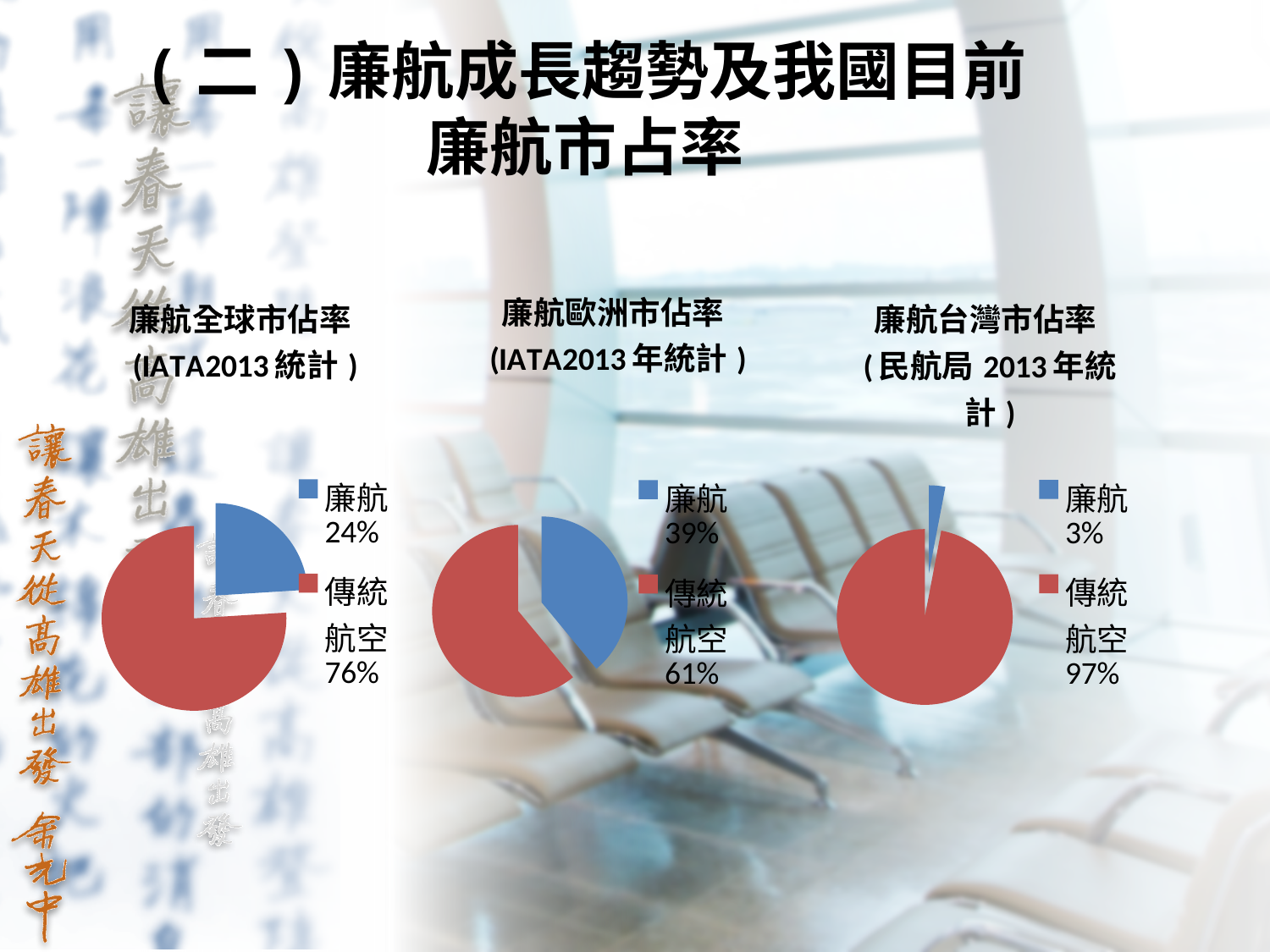
In the right pie chart (廉航台灣市佔率), what share is labelled for 廉航? 3% In the middle pie chart (廉航歐洲市佔率), what share is labelled for 傳統航空? 61% In the left pie chart (廉航全球市佔率), what share is labelled for 廉航? 24% In the middle pie chart (廉航歐洲市佔率), which slice is larger, 廉航 or 傳統航空? 傳統航空 How many slices does the left pie chart (廉航全球市佔率) have? 2 In the middle pie chart (廉航歐洲市佔率), what colour is the 廉航 slice? Blue What kind of chart is used for 廉航全球市佔率? Pie chart In the left pie chart (廉航全球市佔率), what share is labelled for 傳統航空? 76% In the middle pie chart (廉航歐洲市佔率), what share is labelled for 廉航? 39% How many entries does the legend of the right pie chart (廉航台灣市佔率) list? 2 In the right pie chart (廉航台灣市佔率), what share is labelled for 傳統航空? 97% In the right pie chart (廉航台灣市佔率), what is the difference between the 傳統航空 share and the 廉航 share? 94%